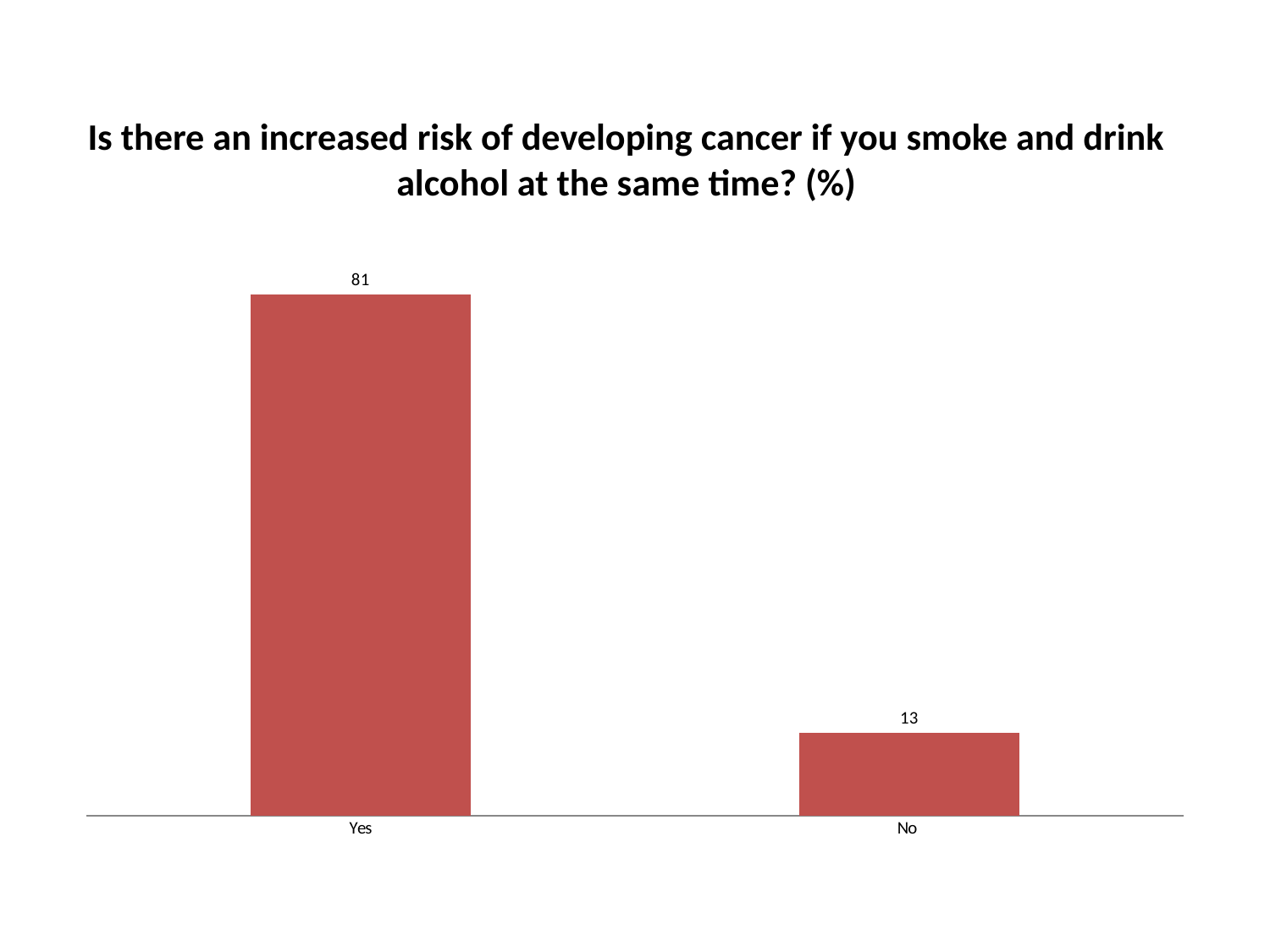
What is the title of the chart? Is there an increased risk of developing cancer if you smoke and drink alcohol at the same time? (%) What is the value for No? 13 How many categories are shown on the chart? 2 Which is larger, the value for Yes or the value for No? Yes What is the difference between the values for Yes and No? 68 What is the value for Yes? 81 What kind of chart is shown on the slide? Bar chart Which category has the lowest value? No Do the values rise or fall from Yes to No along the x axis? Fall What colour are the bars in the chart? Red Which category has the highest value? Yes